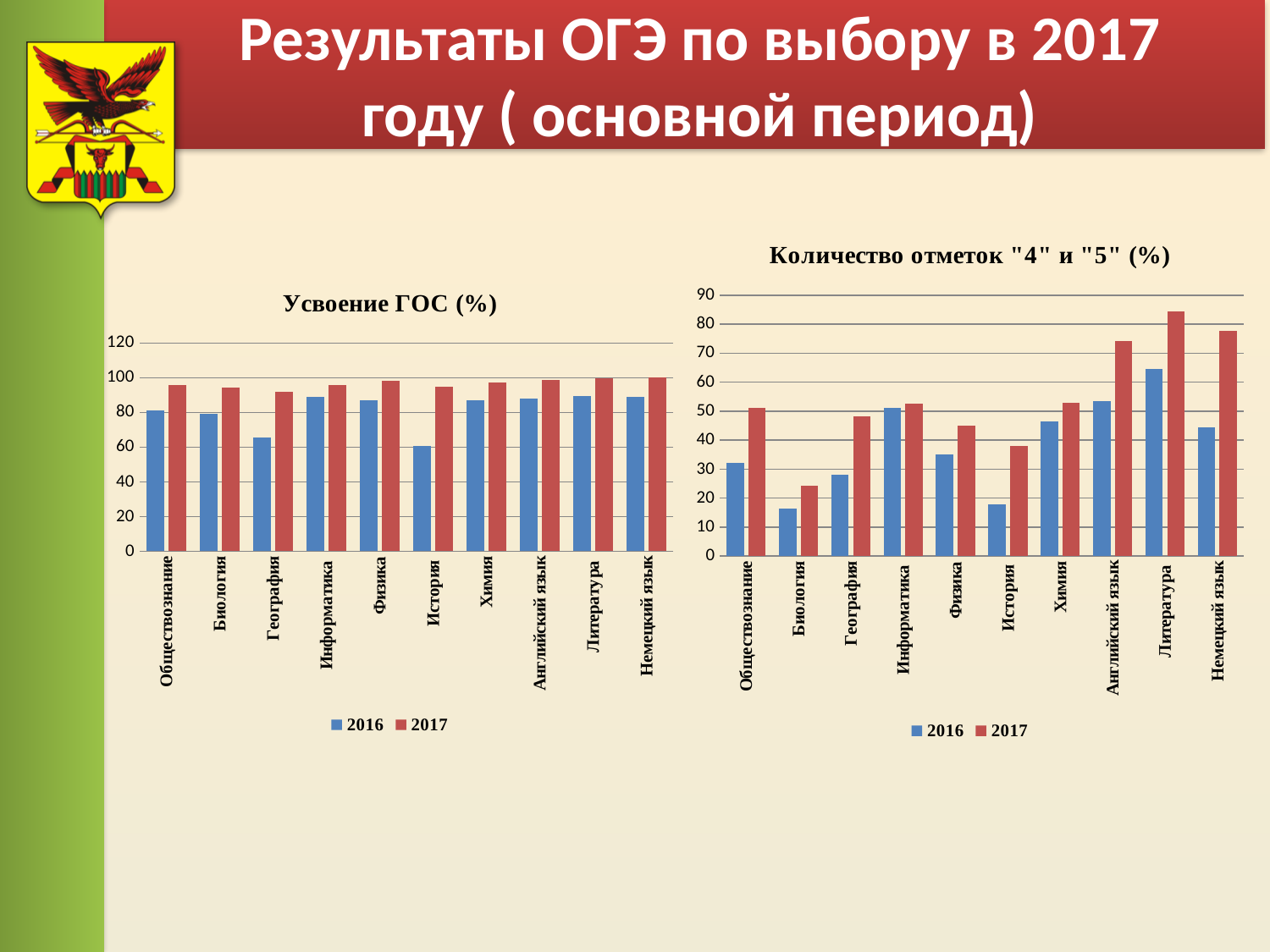
What kind of chart is the "Усвоение ГОС (%)" chart on the left? bar chart How many subject categories are shown on the x axis of the "Усвоение ГОС (%)" chart? 10 In the "Усвоение ГОС (%)" chart, which subject has the lowest 2016 value? История In the "Количество отметок "4" и "5" (%)" chart, is the 2017 value for История greater or less than 30? greater In the "Количество отметок "4" и "5" (%)" chart, which subject has the highest 2017 value? Литература How many series does the legend of the "Количество отметок "4" и "5" (%)" chart list? 2 Which colour represents the 2017 series in the legends of both charts? red In the "Количество отметок "4" и "5" (%)" chart, which is larger for Немецкий язык: the 2016 value or the 2017 value? 2017 In the "Количество отметок "4" и "5" (%)" chart, which subject has the lowest 2016 value? Биология In the "Количество отметок "4" и "5" (%)" chart, is the 2016 value for Литература greater or less than 60? greater In the "Усвоение ГОС (%)" chart, is the 2016 value for География greater or less than 80? less